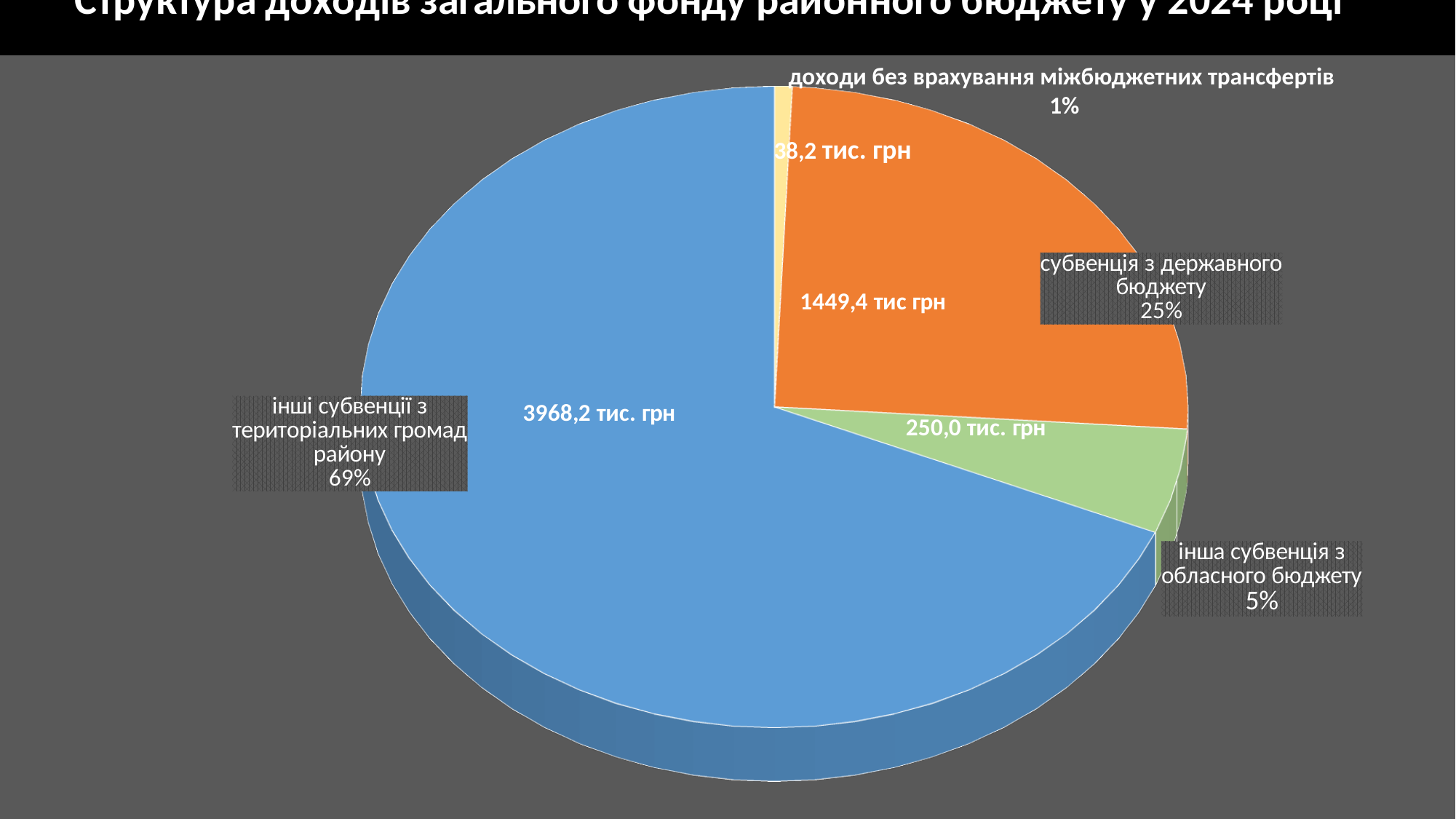
Which category has the largest slice of the pie? інші субвенції з територіальних громад району Which is larger: the value for 'інша субвенція з обласного бюджету' or for 'доходи без врахування міжбюджетних трансфертів'? інша субвенція з обласного бюджету What share of the pie does 'інші субвенції з територіальних громад району' represent? 69% Which category has the smallest slice of the pie? доходи без врахування міжбюджетних трансфертів What is the value shown for 'доходи без врахування міжбюджетних трансфертів'? 38,2 тис. грн What is the value shown for 'інші субвенції з територіальних громад району'? 3968,2 тис. грн What is the difference between the values for 'інші субвенції з територіальних громад району' and 'субвенція з державного бюджету'? 2518,8 тис. грн What is the value shown for 'субвенція з державного бюджету'? 1449,4 тис грн What is the value shown for 'інша субвенція з обласного бюджету'? 250,0 тис. грн How many slices does the pie chart have? 4 What kind of chart is shown on the slide? pie chart What share of the pie does 'субвенція з державного бюджету' represent? 25%